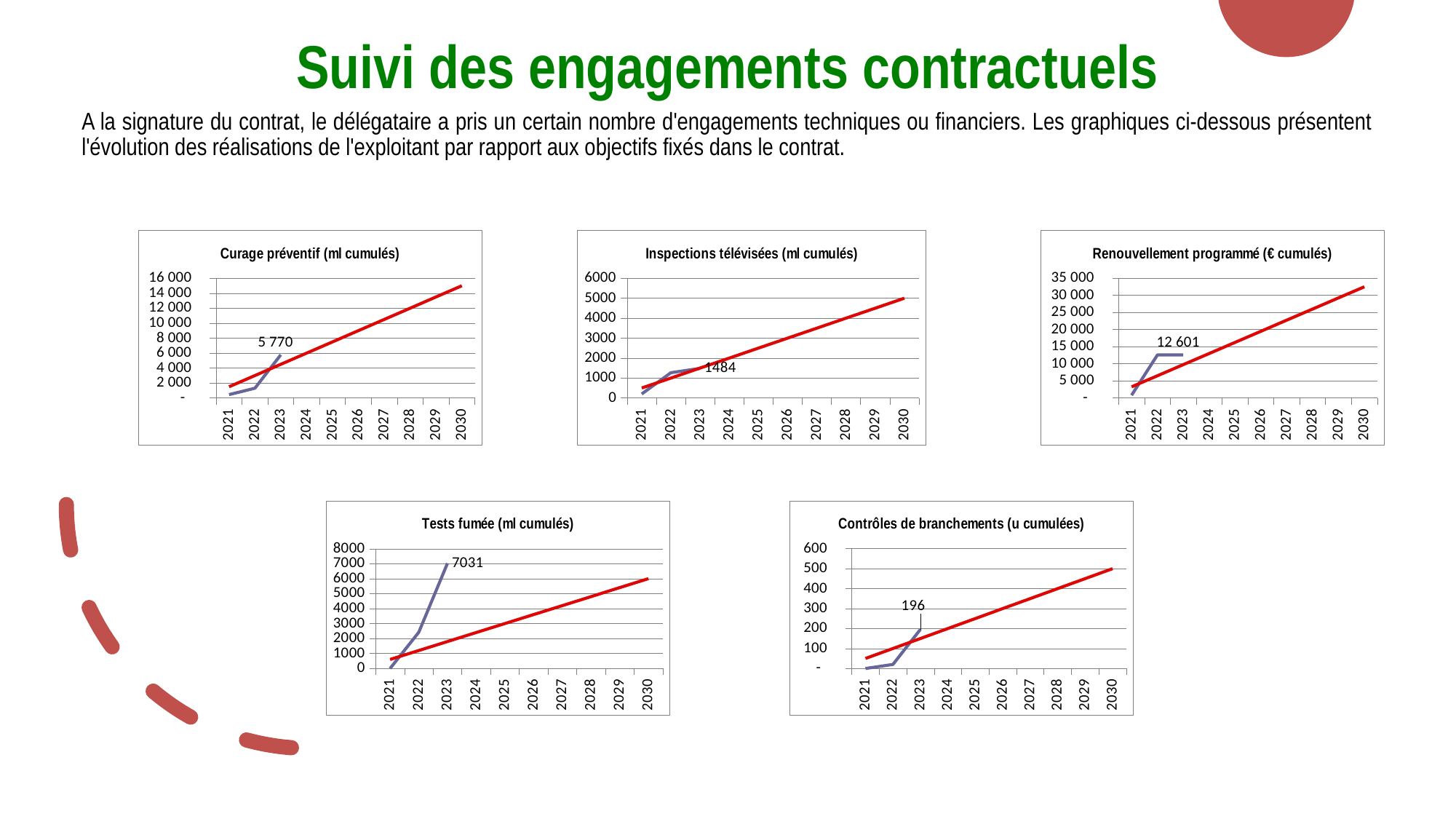
How many years are shown on the x axis of the 'Curage préventif (ml cumulés)' chart? 10 In the 'Curage préventif (ml cumulés)' chart, what value is labelled on the blue line in 2023? 5 770 In the 'Tests fumée (ml cumulés)' chart, which line is higher in 2023, the blue line or the red line? the blue line In the 'Inspections télévisées (ml cumulés)' chart, what value is labelled on the blue line in 2023? 1484 What kind of chart is the 'Tests fumée (ml cumulés)' chart? line chart In the 'Renouvellement programmé (€ cumulés)' chart, what value is labelled on the blue line in 2023? 12 601 In the 'Tests fumée (ml cumulés)' chart, what value is labelled on the blue line in 2023? 7031 In the 'Tests fumée (ml cumulés)' chart, is the value of the red line in 2030 greater or less than 5000? greater In the 'Contrôles de branchements (u cumulées)' chart, is the value of the red line in 2030 greater or less than 400? greater In the 'Renouvellement programmé (€ cumulés)' chart, does the red line rise or fall from 2021 to 2030? rise In the 'Contrôles de branchements (u cumulées)' chart, what value is labelled on the blue line in 2023? 196 What is the title of the chart at the bottom right of the slide? Contrôles de branchements (u cumulées)